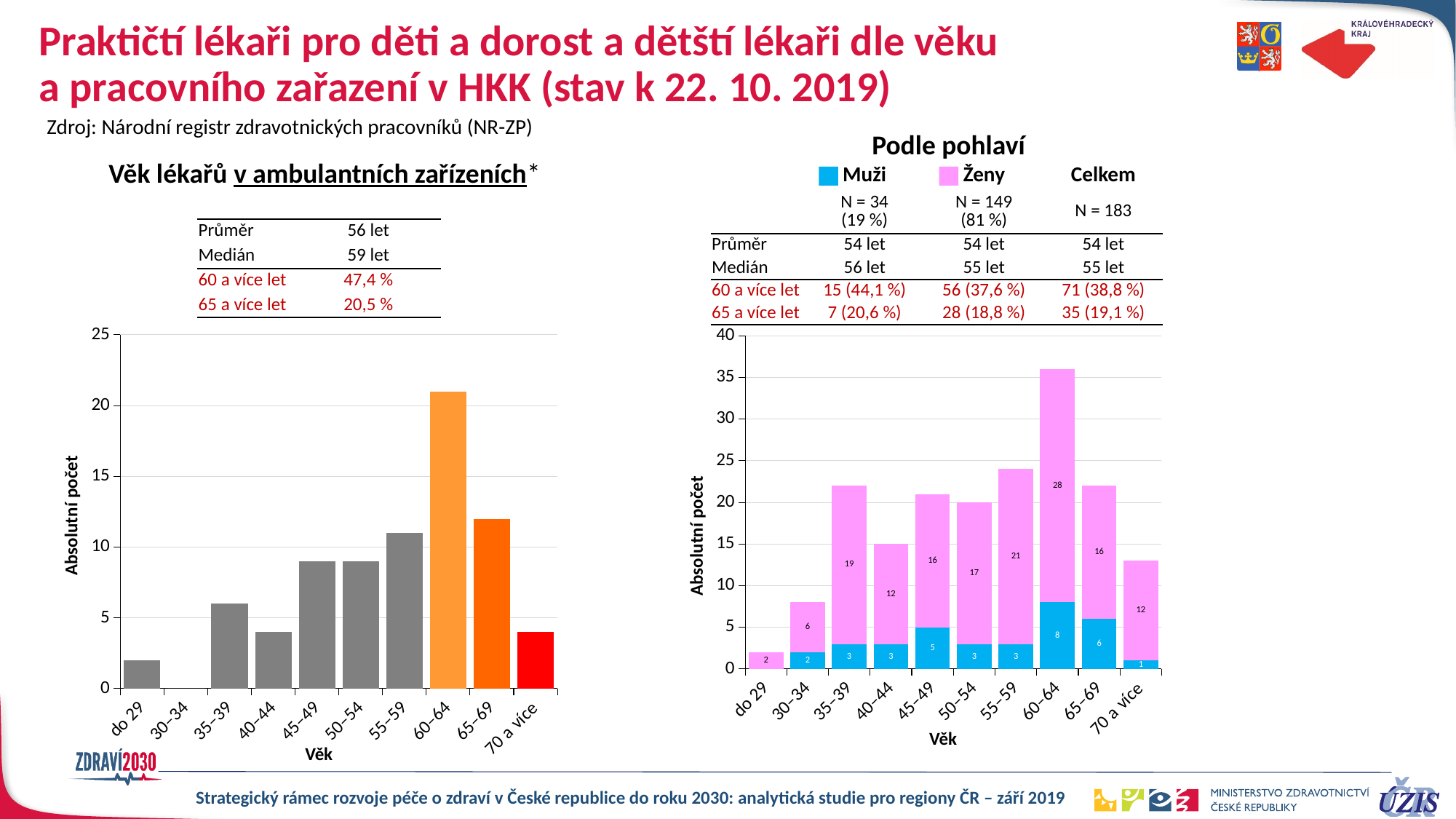
In the 'Podle pohlaví' chart, which age group has the highest value for Ženy? 60–64 In the 'Podle pohlaví' chart, what is the value for Muži in the 60–64 age group? 8 How many series does the legend of the 'Podle pohlaví' chart list? 2 How many age groups are shown on the x axis of the 'Věk lékařů v ambulantních zařízeních' chart on the left? 10 In the 'Podle pohlaví' chart, what is the total of the stacked bar for the 60–64 age group? 36 In the 'Věk lékařů v ambulantních zařízeních' chart on the left, is the value for 65–69 greater or less than 15? less In the 'Podle pohlaví' chart, which is larger: the Ženy value for 50–54 or the Ženy value for 45–49? 50–54 In the 'Věk lékařů v ambulantních zařízeních' chart on the left, which age group has the highest bar? 60–64 In the 'Věk lékařů v ambulantních zařízeních' chart on the left, is the value for 60–64 greater or less than 20? greater In the 'Podle pohlaví' chart, what is the value for Ženy in the 60–64 age group? 28 What kind of chart is the 'Podle pohlaví' chart on the right? stacked bar chart In the 'Podle pohlaví' chart, what is the difference between the Ženy and Muži values in the 55–59 age group? 18